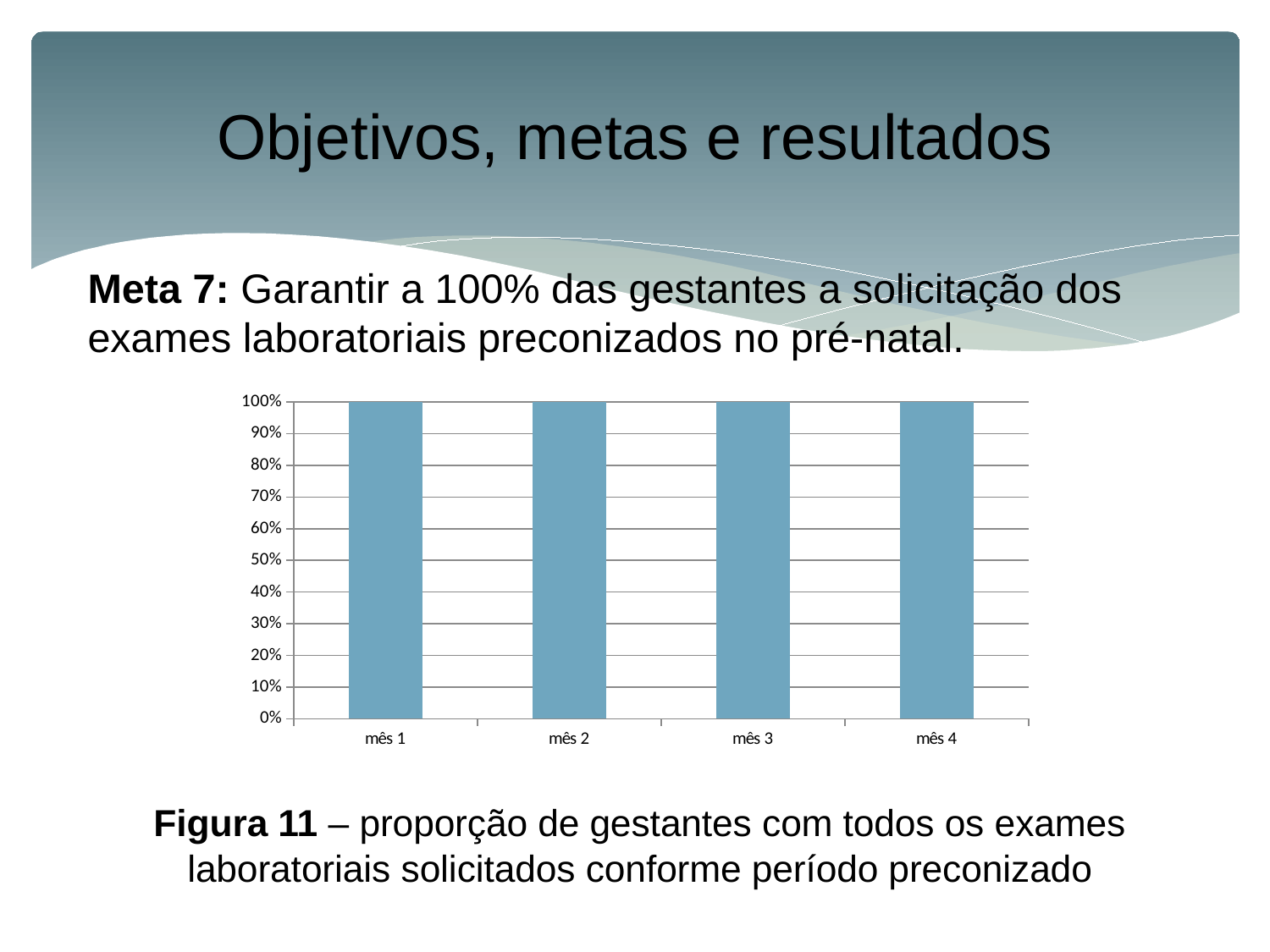
What is the highest value shown on the y axis of the chart? 100% What is the difference between the values for mês 1 and mês 4? 0% What kind of chart is shown on the slide? bar chart How many categories (months) are shown on the x axis of the chart? 4 Is the value for mês 1 greater or less than 50%? greater What is the value for mês 3 in the chart? 100% What is the value for mês 4 in the chart? 100% What is the label of the first category on the x axis? mês 1 What is the value for mês 2 in the chart? 100% Is the value for mês 3 greater or less than 90%? greater Do the values rise, fall, or stay the same from mês 1 to mês 4? stay the same What is the value for mês 1 in the chart? 100%